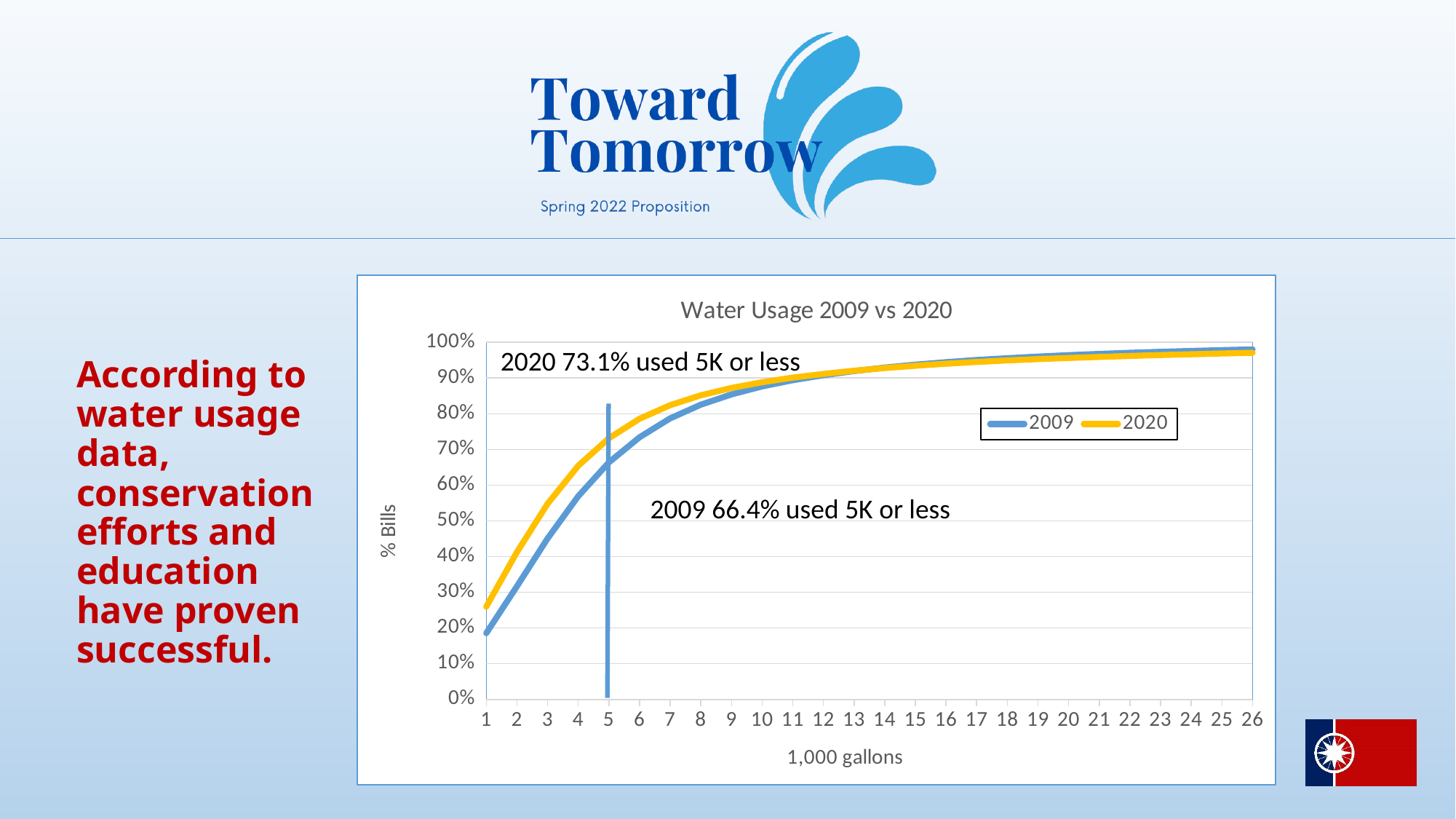
Is the value for the 2020 series at 1 (1,000 gallons) greater or less than 30%? less Is the value for the 2009 series at 10 (1,000 gallons) greater or less than 80%? greater According to the annotation, what percentage of bills in 2009 used 5K gallons or less? 66.4% How many usage points (in 1,000 gallons) are labelled along the x axis? 26 How many series does the legend of the Water Usage 2009 vs 2020 chart list? 2 By how many percentage points does the 2020 share of bills using 5K or less exceed the 2009 share? 6.7 percentage points What is the label of the y axis of the chart? % Bills Do the values of the 2009 series rise or fall as usage increases along the x axis? rise What kind of chart is shown on the slide? line chart According to the annotation, what percentage of bills in 2020 used 5K gallons or less? 73.1% What is the title of the chart? Water Usage 2009 vs 2020 At 5,000 gallons, which series has the higher % of bills, 2009 or 2020? 2020